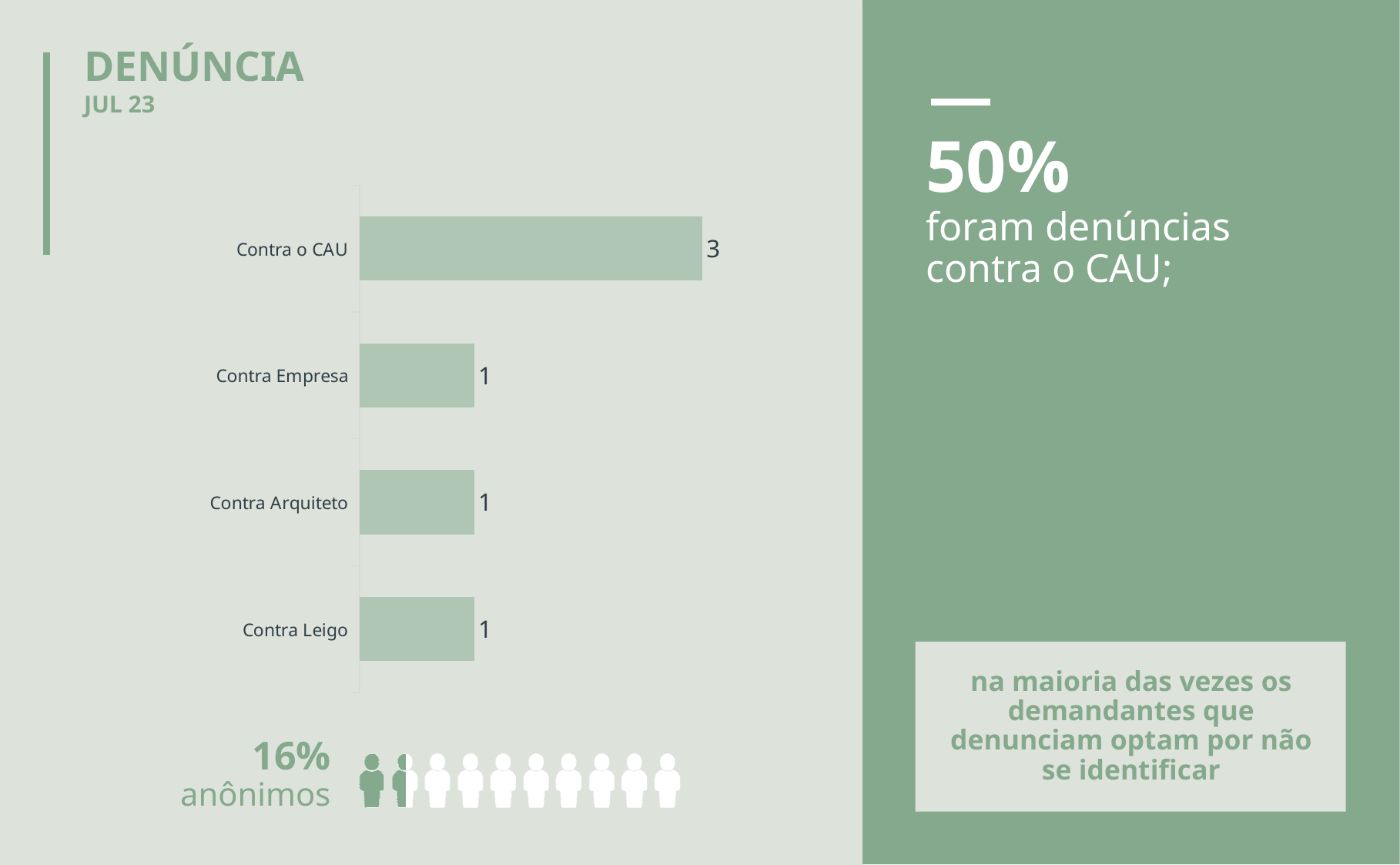
What is the value for Contra o CAU? 3 How many categories are shown in the bar chart? 4 What is the title of the slide containing the chart? DENÚNCIA What month and year does the chart refer to, as shown under the title? JUL 23 Which is larger, the value for Contra o CAU or the value for Contra Leigo? Contra o CAU What kind of chart is shown on the slide? bar chart Which category has the highest value? Contra o CAU What is the value for Contra Leigo? 1 What is the value for Contra Empresa? 1 What is the difference between the values for Contra o CAU and Contra Empresa? 2 What is the total of all the values shown in the bar chart? 6 What is the value for Contra Arquiteto? 1